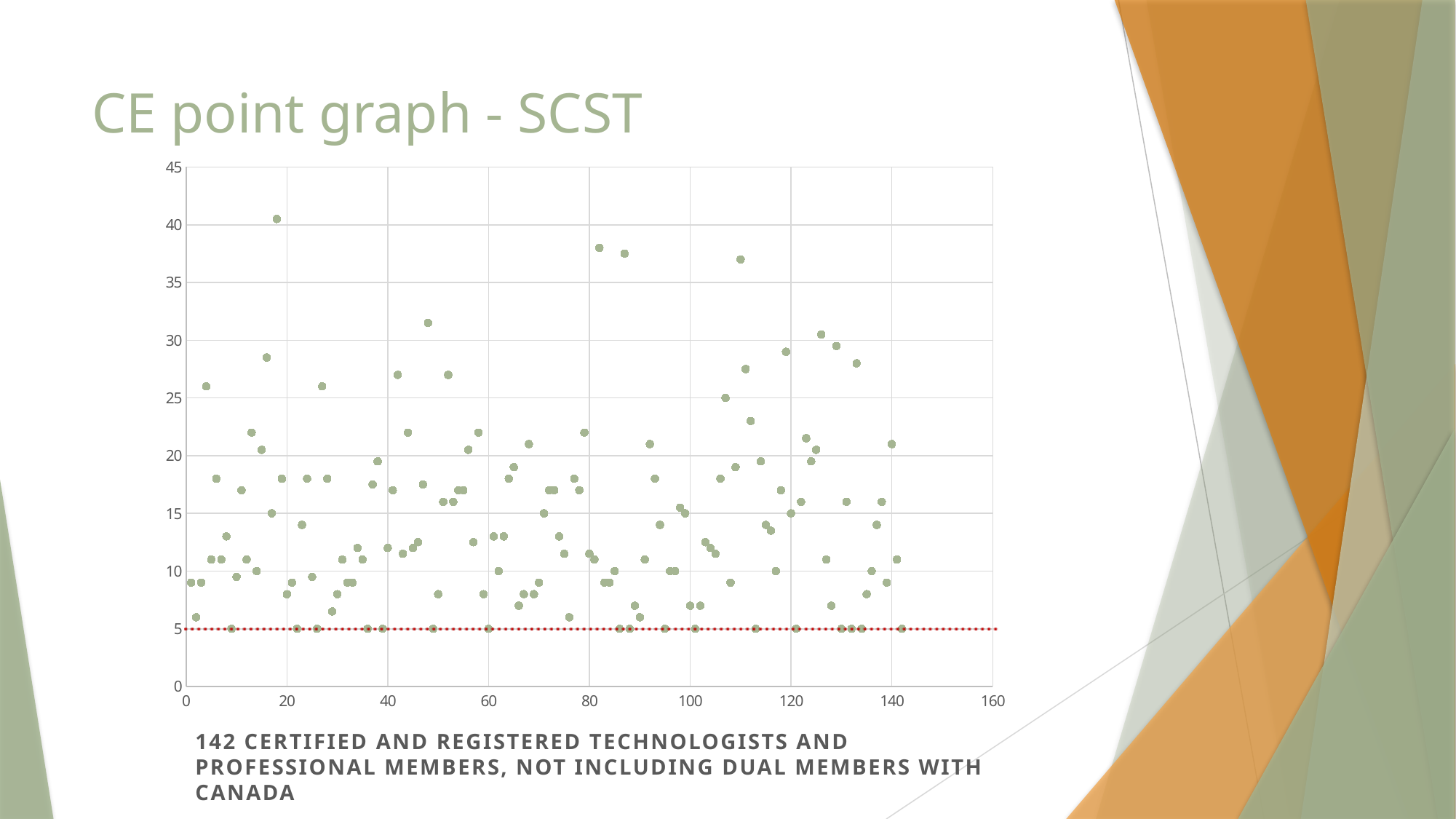
Is the lowest plotted point greater or less than 10? less Are any plotted points above 45 on the vertical axis? no Is the highest point near x = 110 greater or less than 35? greater What kind of chart is shown on the slide? scatter plot What is the highest value shown on the vertical axis of the chart? 45 At what vertical-axis value does the red dotted horizontal line sit? 5 What is the highest value shown on the horizontal axis of the chart? 160 What is the title of the chart? CE point graph - SCST According to the caption below the chart, how many certified and registered technologists and professional members are plotted? 142 Do the plotted values show a clear rising or falling trend along the x axis? no clear trend